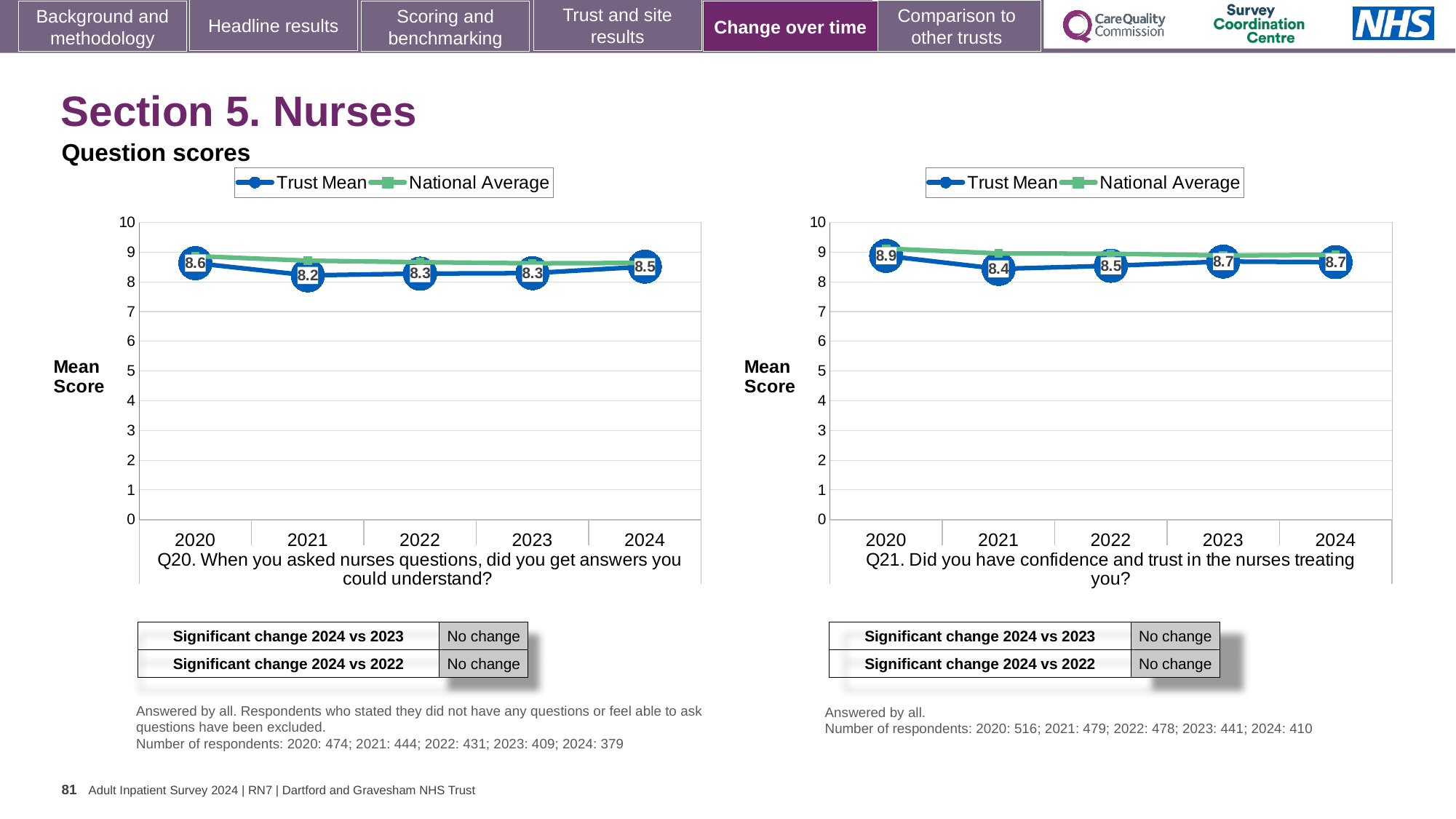
In the Q21 chart (right), is the Trust Mean score for 2020 or 2024 larger? 2020 In the Q21 chart (right), what is the Trust Mean score for 2020? 8.9 How many years are plotted on the x axis of the Q20 chart (left)? 5 In the Q20 chart (left), which year has the highest Trust Mean score? 2020 What type of chart is the Q20 chart (left)? Line chart In the Q21 chart (right), is the National Average for 2020 greater or less than 8? greater How many series does the legend of the Q21 chart (right) list? 2 In the Q20 chart (left), what is the Trust Mean score for 2021? 8.2 In the Q20 chart (left), what is the Trust Mean score for 2024? 8.5 In the Q21 chart (right), which year has the lowest Trust Mean score? 2021 In the Q20 chart (left), what is the difference between the Trust Mean scores for 2020 and 2021? 0.4 In the Q21 chart (right), what is the Trust Mean score for 2022? 8.5